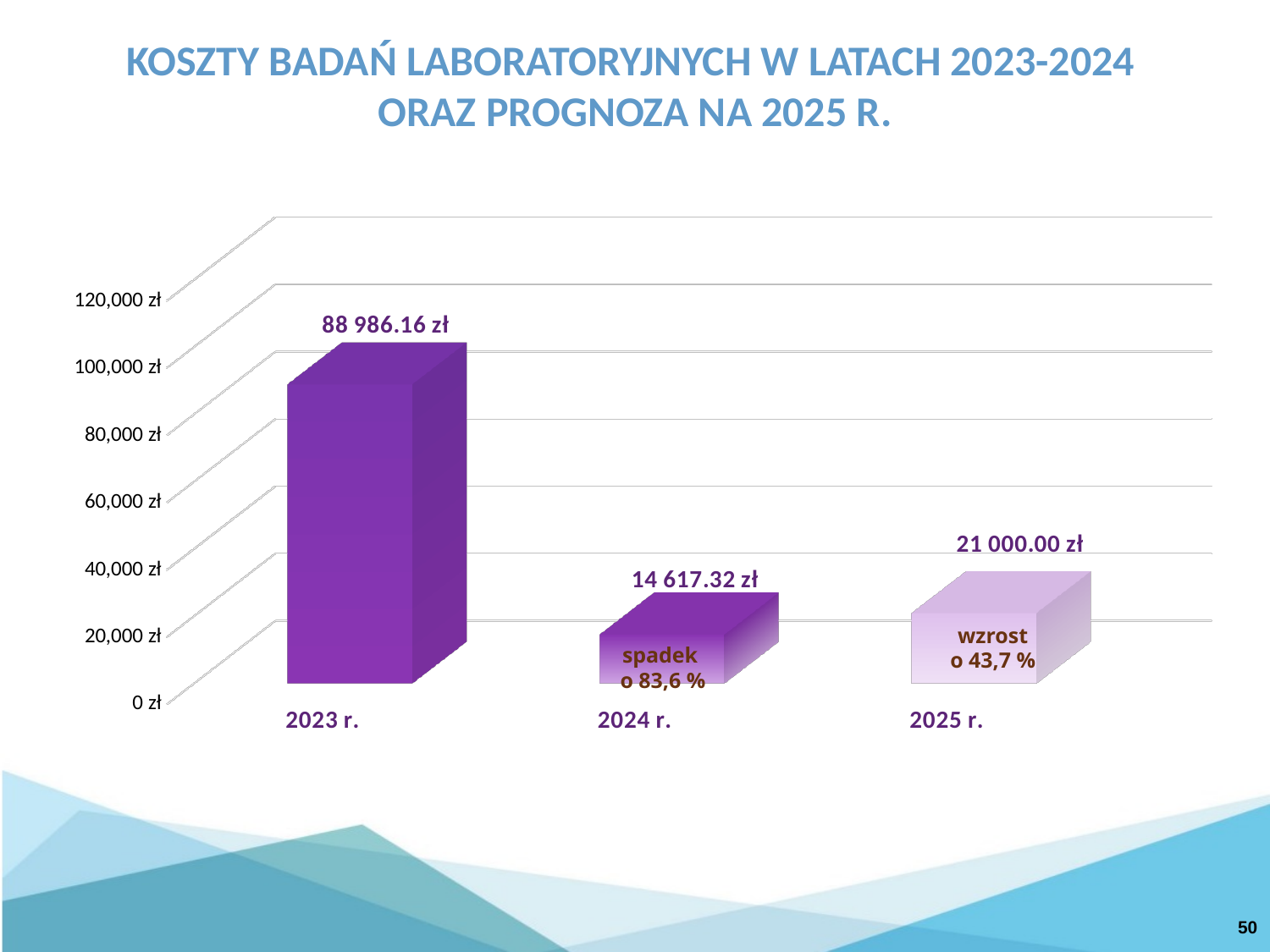
How many years are shown on the chart? 3 What is the value shown for 2024 r.? 14 617.32 zł Which is larger, the value for 2024 r. or the value for 2025 r.? 2025 r. Which year has the lowest laboratory testing cost? 2024 r. What percentage decrease is annotated on the 2024 r. bar? 83,6 % What kind of chart is shown on the slide? bar chart Which year has the highest laboratory testing cost? 2023 r. Is the value for 2023 r. greater or less than 80,000 zł? greater What is the difference between the values for 2025 r. and 2024 r.? 6 382.68 zł What is the value shown for 2023 r.? 88 986.16 zł What is the difference between the values for 2023 r. and 2024 r.? 74 368.84 zł What is the forecast value shown for 2025 r.? 21 000.00 zł